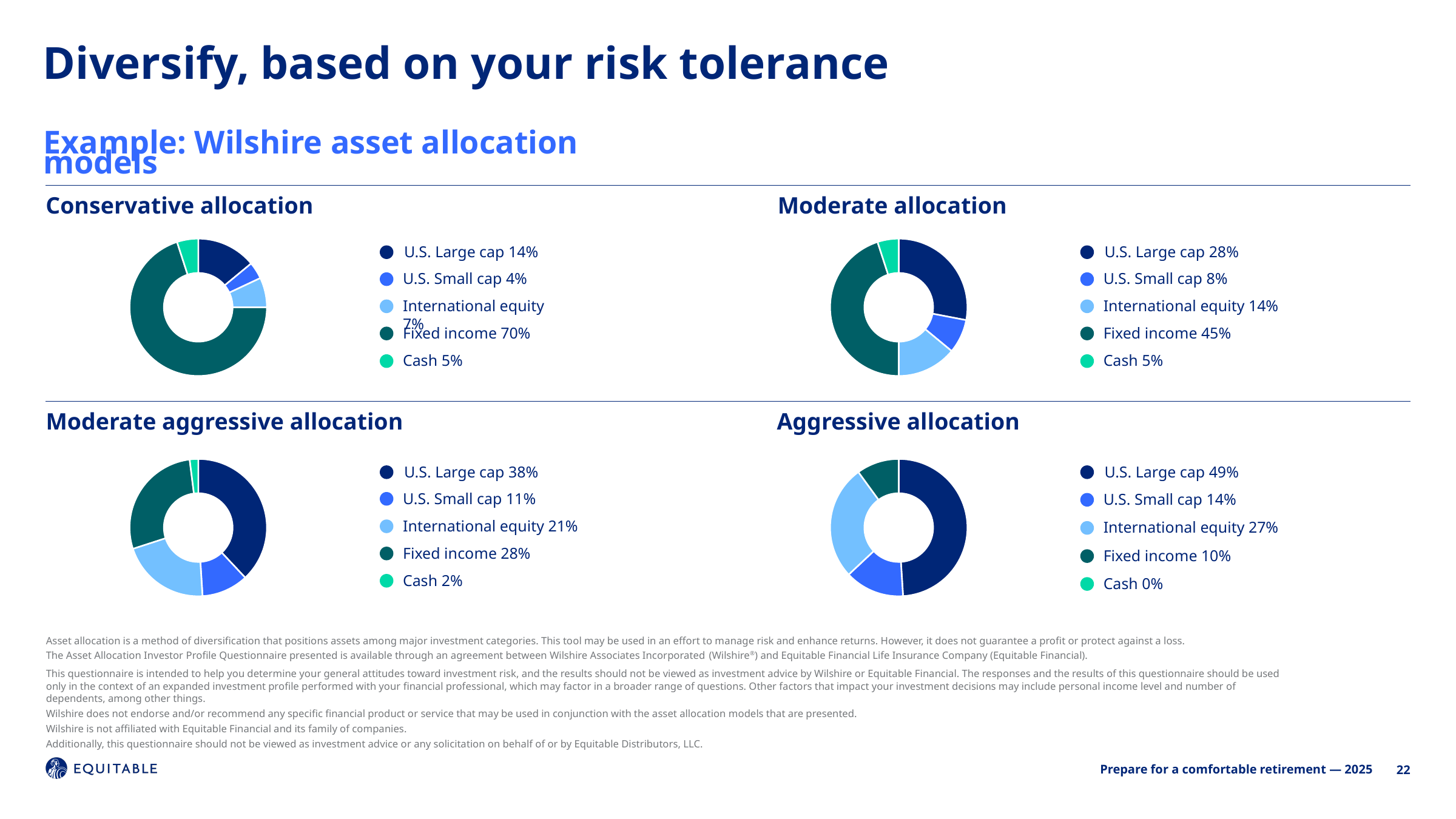
In the Moderate allocation chart, what is the difference between Fixed income and U.S. Large cap? 17% In the Conservative allocation chart, what share is Fixed income? 70% How many charts are shown on the slide? 4 In the Moderate allocation chart, what colour represents Fixed income? Dark teal In the Moderate aggressive allocation chart, which is larger, U.S. Large cap or Fixed income? U.S. Large cap In the Aggressive allocation chart, which category has the largest share? U.S. Large cap In the Moderate allocation chart, what share is U.S. Large cap? 28% How many categories does the Aggressive allocation chart's legend list? 5 What kind of chart is the Conservative allocation chart? Doughnut chart In the Aggressive allocation chart, what share is Cash? 0% In the Conservative allocation chart, which category has the smallest share? U.S. Small cap In the Moderate aggressive allocation chart, what share is International equity? 21%